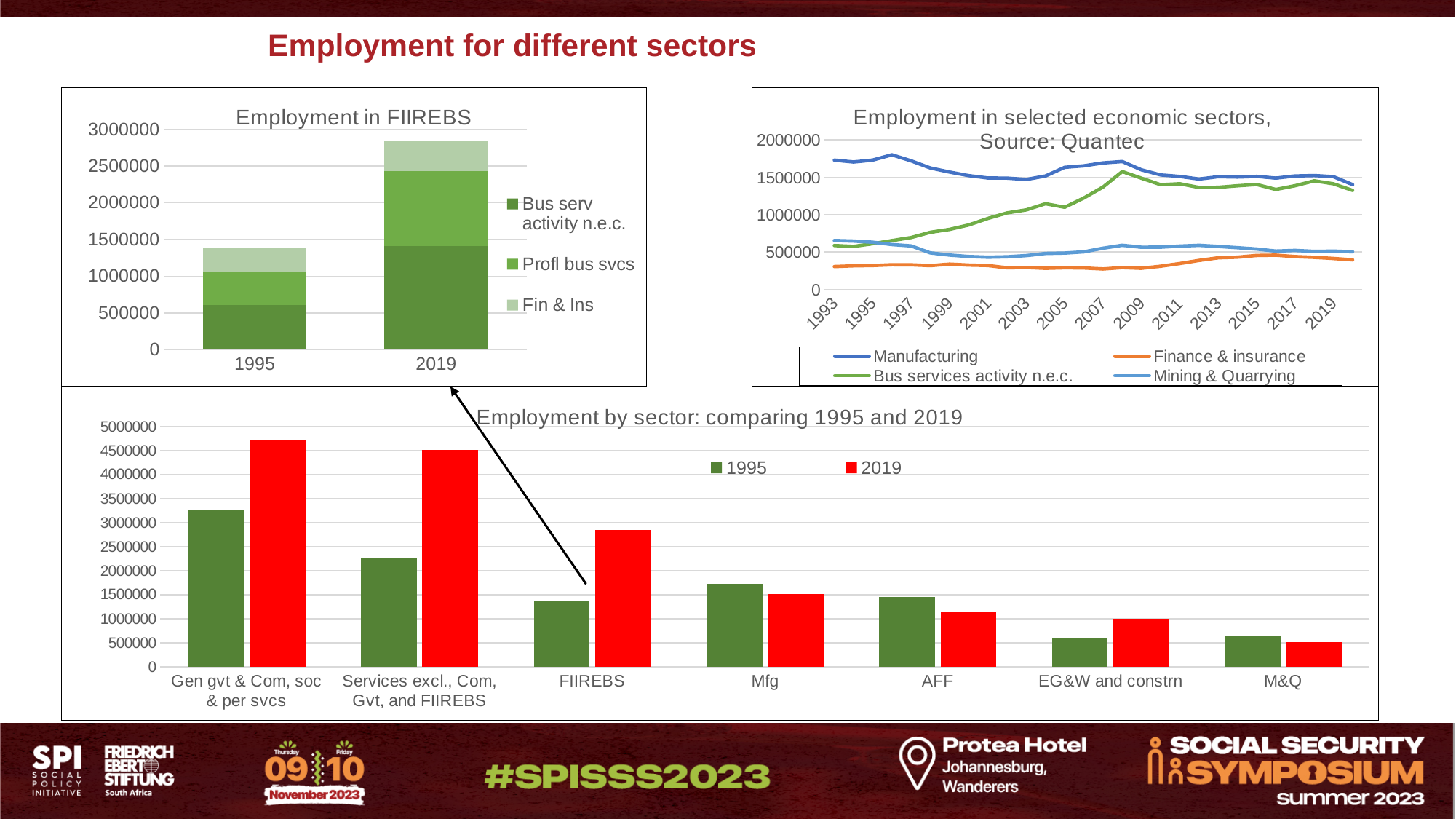
What kind of chart is the "Employment in FIIREBS" chart? Stacked bar chart In the "Employment in selected economic sectors, Source: Quantec" chart, which series has the highest value in 1993? Manufacturing In the "Employment in FIIREBS" chart, is the total for 2019 greater or less than 2500000? greater How many sector categories are shown in the "Employment by sector: comparing 1995 and 2019" chart? 7 How many series does the legend of the "Employment in FIIREBS" chart list? 3 In the "Employment in selected economic sectors, Source: Quantec" chart, is the value for Finance & insurance in 2019 greater or less than 500000? less In the "Employment by sector: comparing 1995 and 2019" chart, which is larger for Mfg, the 1995 value or the 2019 value? 1995 In the "Employment by sector: comparing 1995 and 2019" chart, is the 1995 value for Mfg greater or less than 1500000? greater In the "Employment by sector: comparing 1995 and 2019" chart, which sector has the lowest 2019 value? M&Q How many series does the legend of the "Employment in selected economic sectors, Source: Quantec" chart list? 4 In the "Employment by sector: comparing 1995 and 2019" chart, which is larger for FIIREBS, the 1995 value or the 2019 value? 2019 In the "Employment in selected economic sectors, Source: Quantec" chart, does the Bus services activity n.e.c. line rise or fall from 1993 to 2019? rise